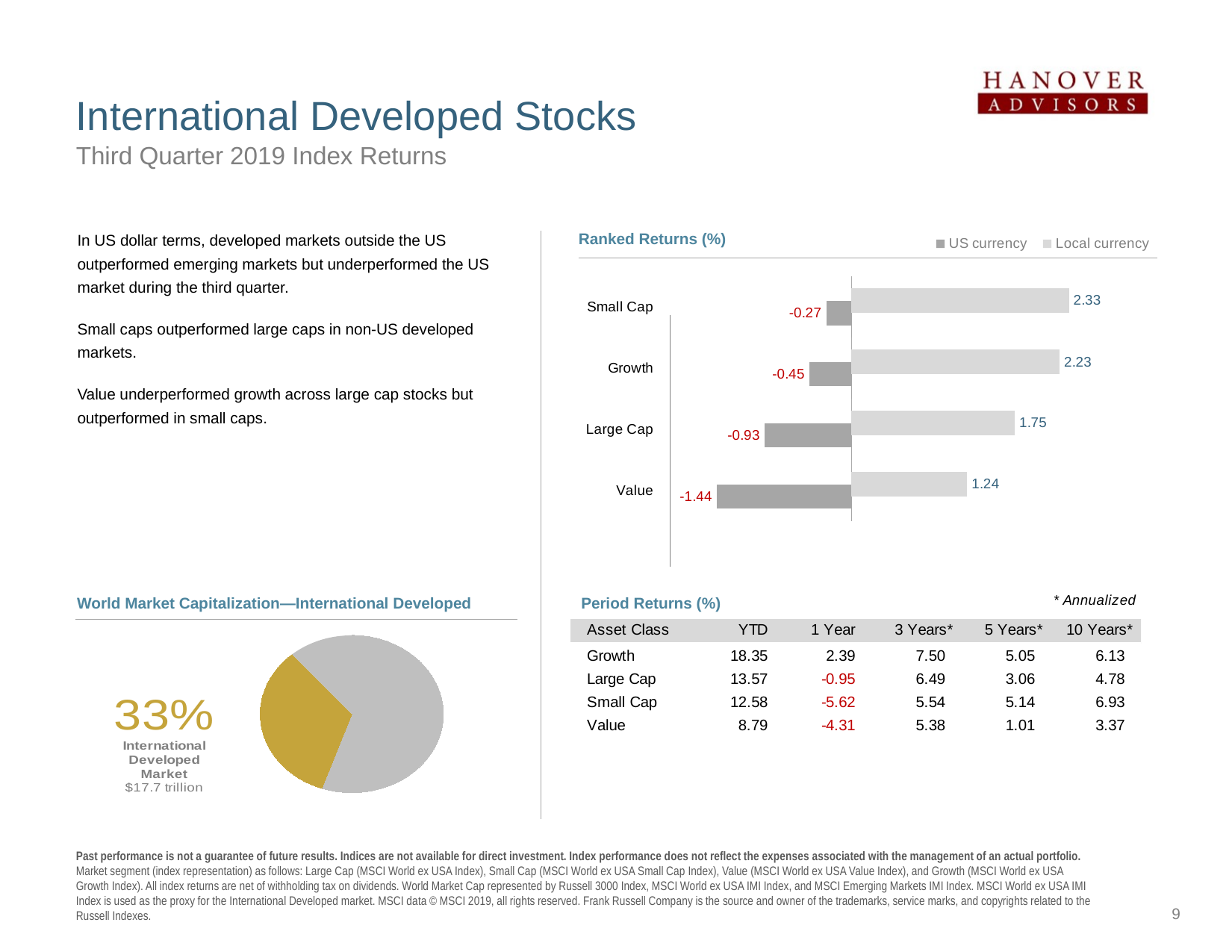
In the Ranked Returns (%) chart, what is the difference between the Local currency values for Growth and Value? 0.99 In the Ranked Returns (%) chart, which category has the highest Local currency value? Small Cap In the Ranked Returns (%) chart, which category has the lowest US currency value? Value How many series does the legend of the Ranked Returns (%) chart list? 2 In the Ranked Returns (%) chart, what is the US currency value for Large Cap? -0.93 How many categories are shown in the Ranked Returns (%) chart? 4 In the Ranked Returns (%) chart, what is the Local currency value for Small Cap? 2.33 In the Ranked Returns (%) chart, which is larger: the Local currency value for Growth or for Large Cap? Growth What kind of chart is the Ranked Returns (%) chart? Bar chart In the World Market Capitalization—International Developed pie chart, what share does the International Developed Market represent? 33% In the Ranked Returns (%) chart, what is the US currency value for Value? -1.44 What kind of chart is the World Market Capitalization—International Developed chart? Pie chart